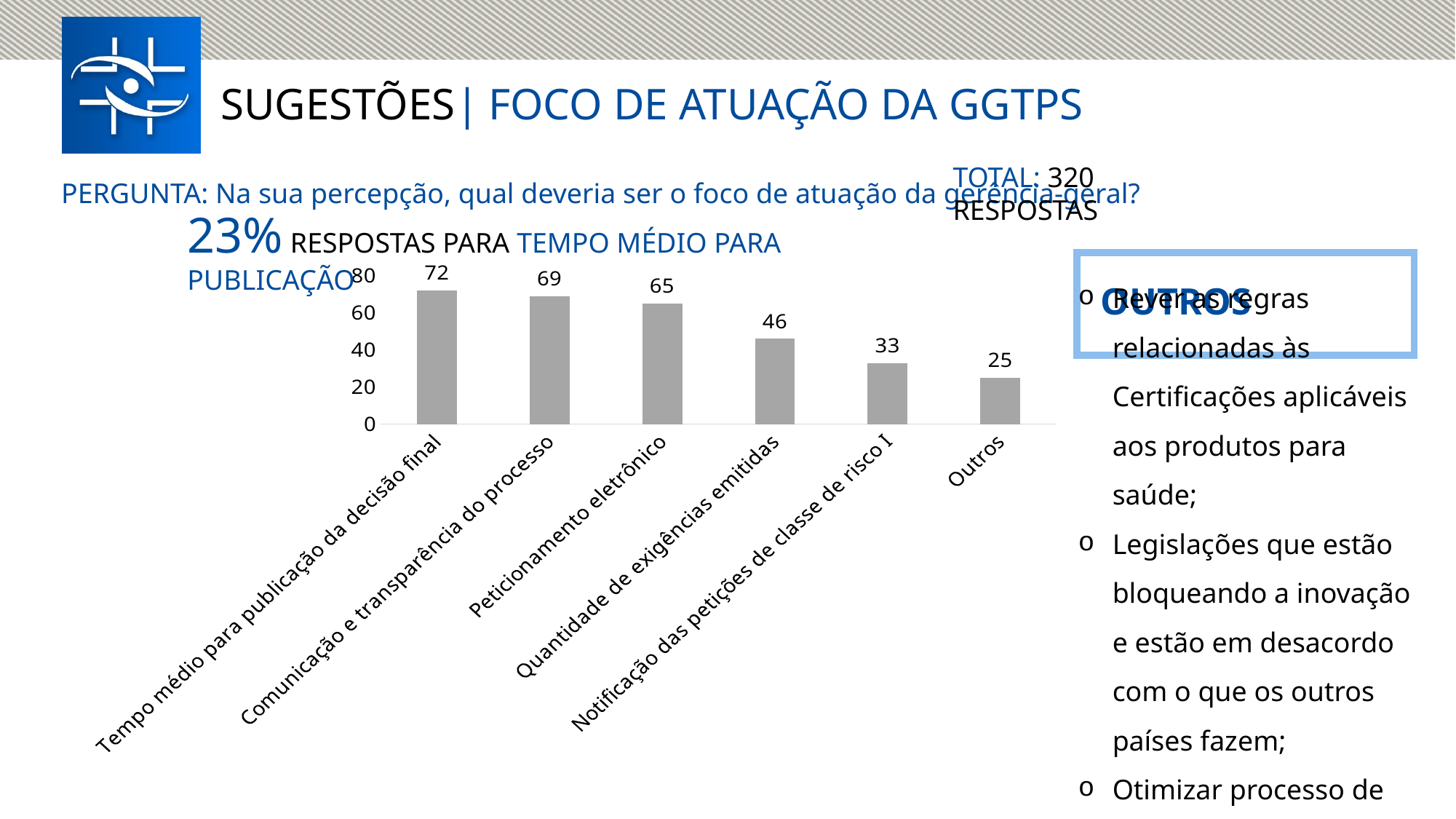
Do the values rise or fall from left to right along the x axis? fall What is the value for "Quantidade de exigências emitidas"? 46 What kind of chart is shown on the slide? bar chart Is the value for "Notificação das petições de classe de risco I" greater or less than 40? less How many categories are shown in the chart? 6 Which is larger, the value for "Peticionamento eletrônico" or the value for "Quantidade de exigências emitidas"? Peticionamento eletrônico What is the value for "Peticionamento eletrônico"? 65 Which category has the highest value? Tempo médio para publicação da decisão final Which category has the lowest value? Outros What is the difference between the values for "Quantidade de exigências emitidas" and "Notificação das petições de classe de risco I"? 13 What is the difference between the values for "Tempo médio para publicação da decisão final" and "Comunicação e transparência do processo"? 3 What is the value for "Outros"? 25